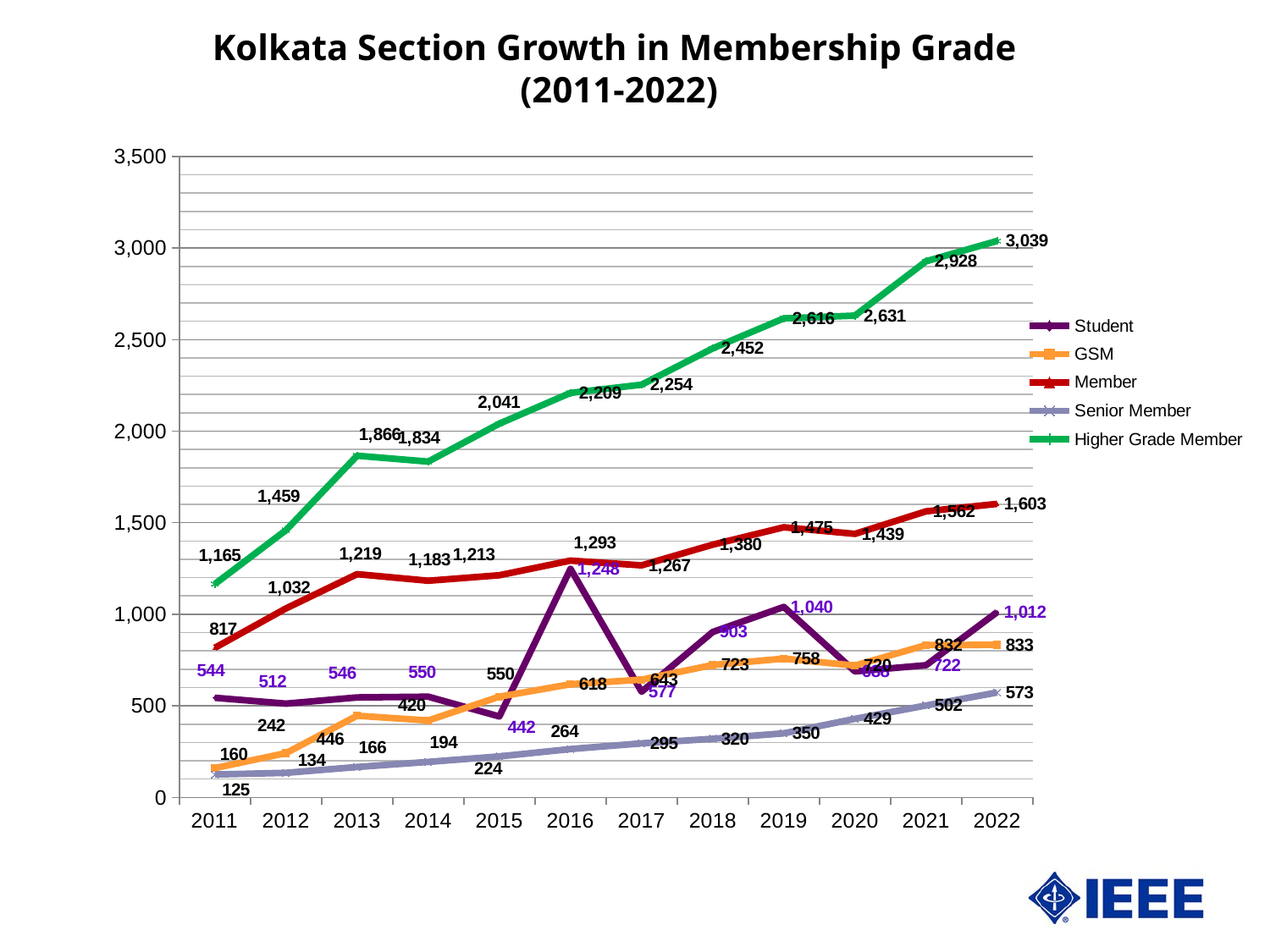
In which year is the Higher Grade Member series at its lowest? 2011 How many years are plotted on the x axis? 12 What type of chart is shown on the slide? Line chart What is the value for Higher Grade Member in 2022? 3,039 Does the Senior Member series rise or fall from 2011 to 2022? Rise What is the value for Senior Member in 2011? 125 What is the value for Member in 2019? 1,475 What is the value for GSM in 2016? 618 In which year is the Student series at its highest? 2016 Which is larger in 2015, the GSM value or the Student value? GSM How many series does the legend list? 5 What is the difference between the Higher Grade Member values in 2022 and 2011? 1,874